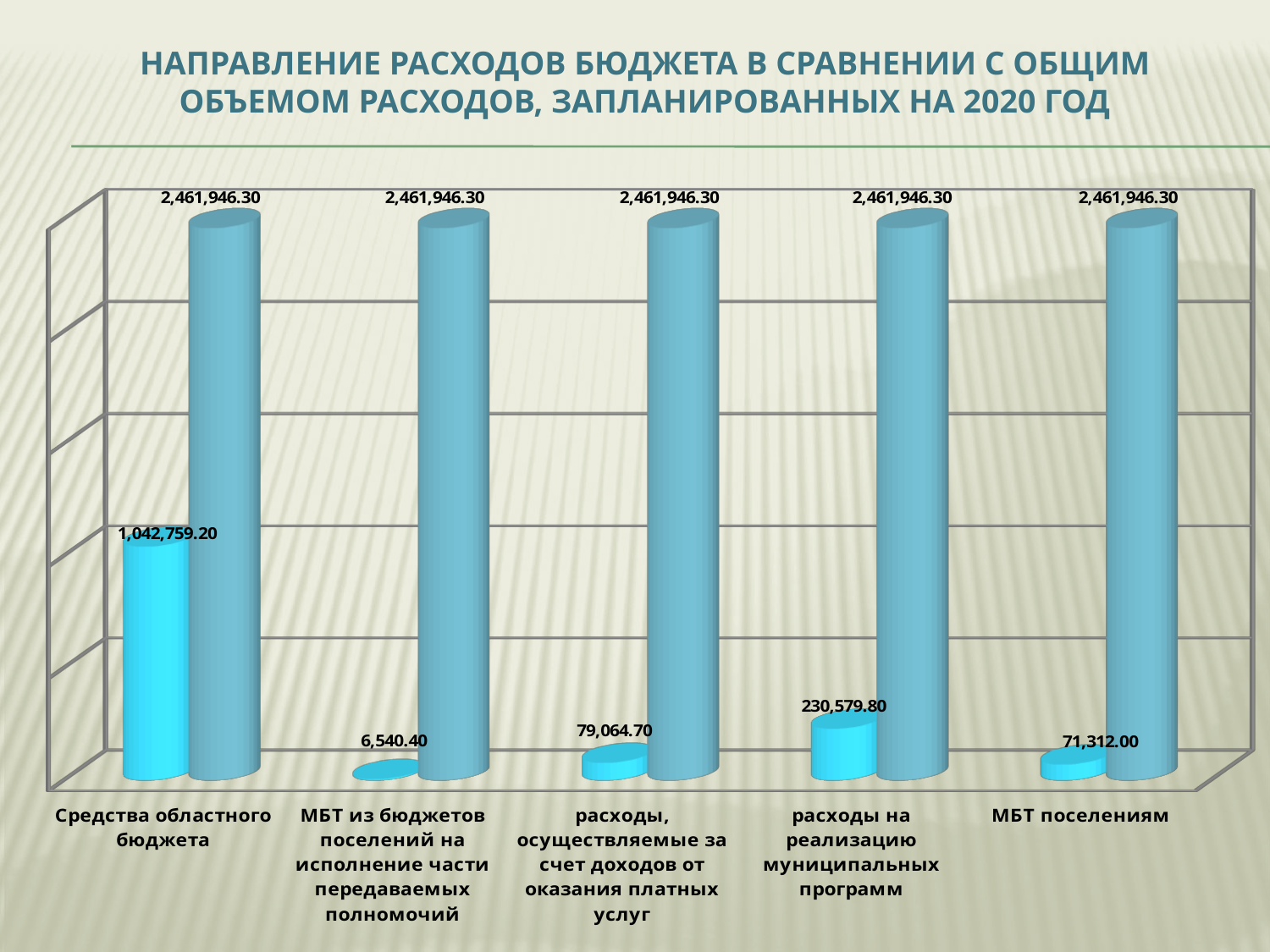
Which category has the highest light-blue bar? Средства областного бюджета What is the value of the light-blue bar for «МБТ из бюджетов поселений на исполнение части передаваемых полномочий»? 6,540.40 What is the value of the light-blue bar for «Средства областного бюджета»? 1,042,759.20 What is the difference between the values for «расходы на реализацию муниципальных программ» and «расходы, осуществляемые за счет доходов от оказания платных услуг»? 151,515.10 How many categories are shown on the x axis of the chart? 5 Which category has the lowest light-blue bar? МБТ из бюджетов поселений на исполнение части передаваемых полномочий What is the value of the light-blue bar for «расходы, осуществляемые за счет доходов от оказания платных услуг»? 79,064.70 What is the value of the light-blue bar for «расходы на реализацию муниципальных программ»? 230,579.80 What is the value of the light-blue bar for «МБТ поселениям»? 71,312.00 What value is shown on each of the tall dark-blue bars representing the total planned expenditure? 2,461,946.30 What is the difference between the total planned expenditure (2,461,946.30) and the value for «Средства областного бюджета»? 1,419,187.10 Which is larger: the value for «МБТ поселениям» or the value for «расходы, осуществляемые за счет доходов от оказания платных услуг»? расходы, осуществляемые за счет доходов от оказания платных услуг